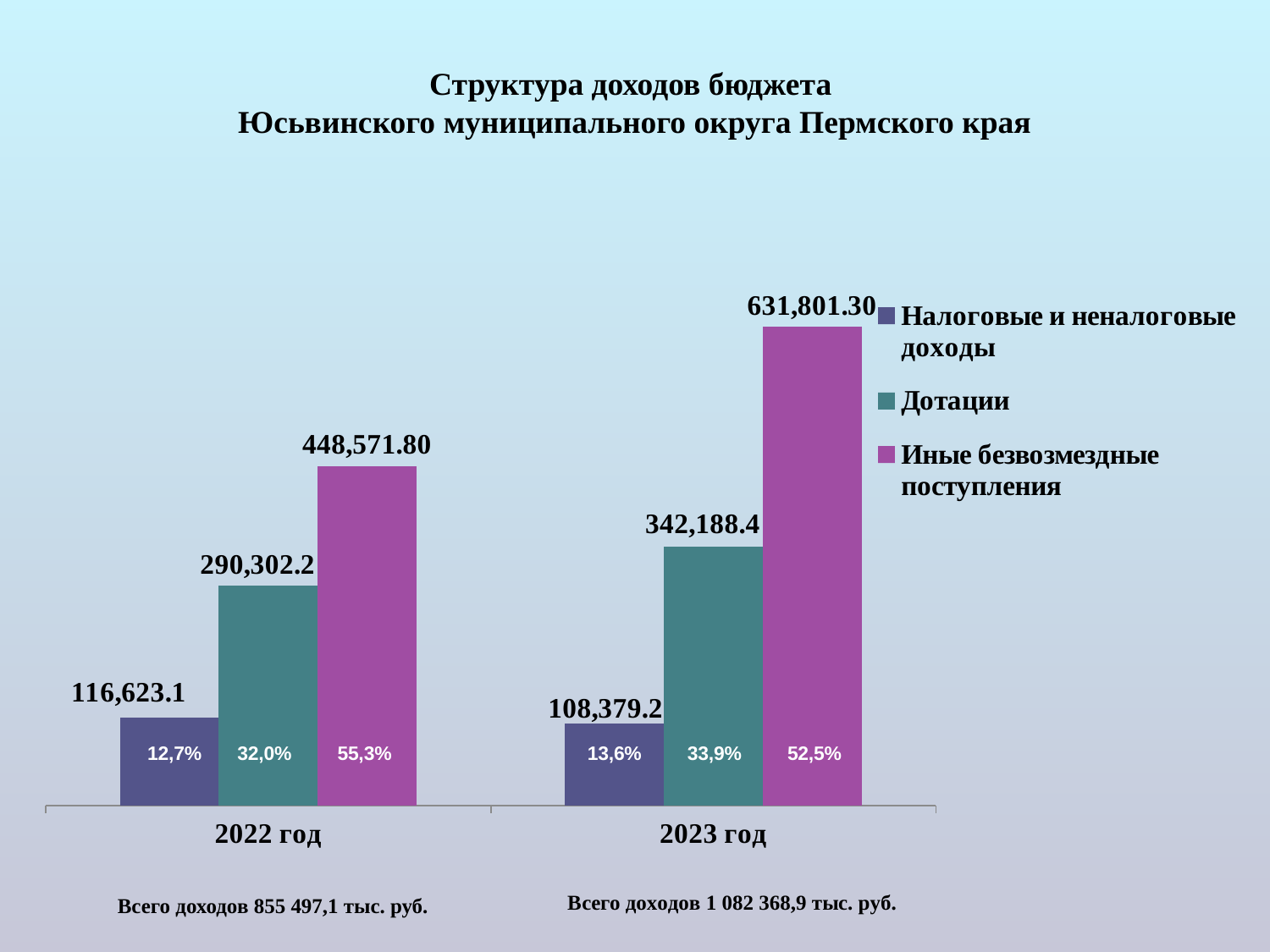
Which series has the highest value in 2022 год? Иные безвозмездные поступления How many series does the legend list? 3 What type of chart is shown on the slide? Bar chart What is the value of Дотации for 2022 год? 290,302.2 What is the difference between the Дотации values for 2023 год and 2022 год? 51,886.2 What is the difference between the Иные безвозмездные поступления values for 2023 год and 2022 год? 183,229.50 What percentage share is shown inside the Дотации bar for 2023 год? 33,9% Which is larger: Налоговые и неналоговые доходы in 2022 год or in 2023 год? 2022 год Which series has the lowest value in 2023 год? Налоговые и неналоговые доходы How many categories (years) are shown on the x axis? 2 What is the value of Налоговые и неналоговые доходы for 2023 год? 108,379.2 What is the value of Иные безвозмездные поступления for 2023 год? 631,801.30